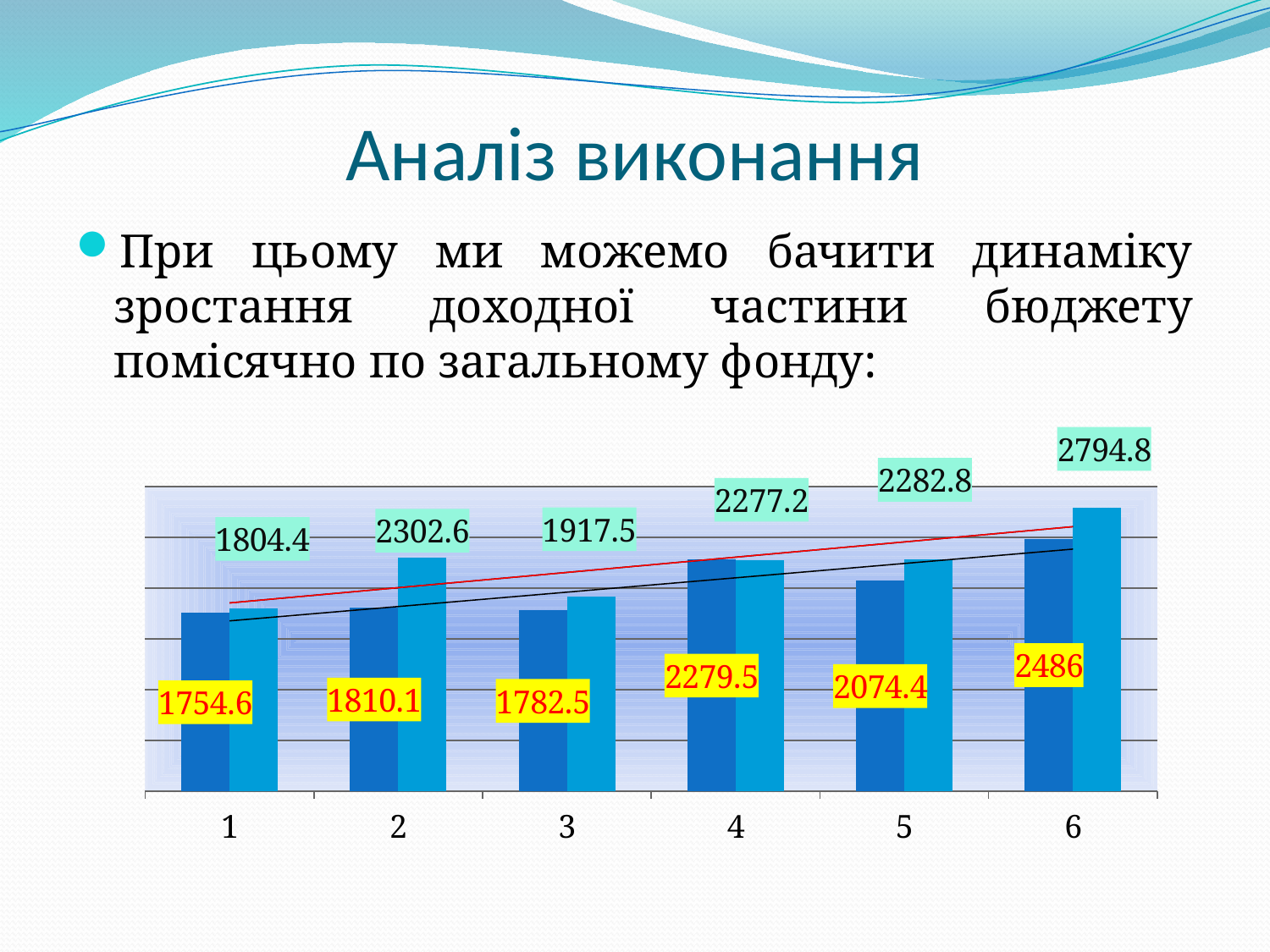
What is the value of the dark blue bar for category 5? 2074.4 What kind of chart is shown on the slide? bar chart Which is larger for category 4, the dark blue bar or the light blue bar? the dark blue bar What is the difference between the light blue bar for category 2 and the light blue bar for category 3? 385.1 How many categories are shown on the x axis? 6 Do the trend lines drawn across the chart rise or fall from category 1 to category 6? rise What is the value of the dark blue bar for category 1? 1754.6 What is the value of the light blue bar for category 2? 2302.6 Which category has the lowest dark blue bar? 1 What is the value of the light blue bar for category 6? 2794.8 What is the difference between the light blue and dark blue bars for category 6? 308.8 Which category has the highest light blue bar? 6